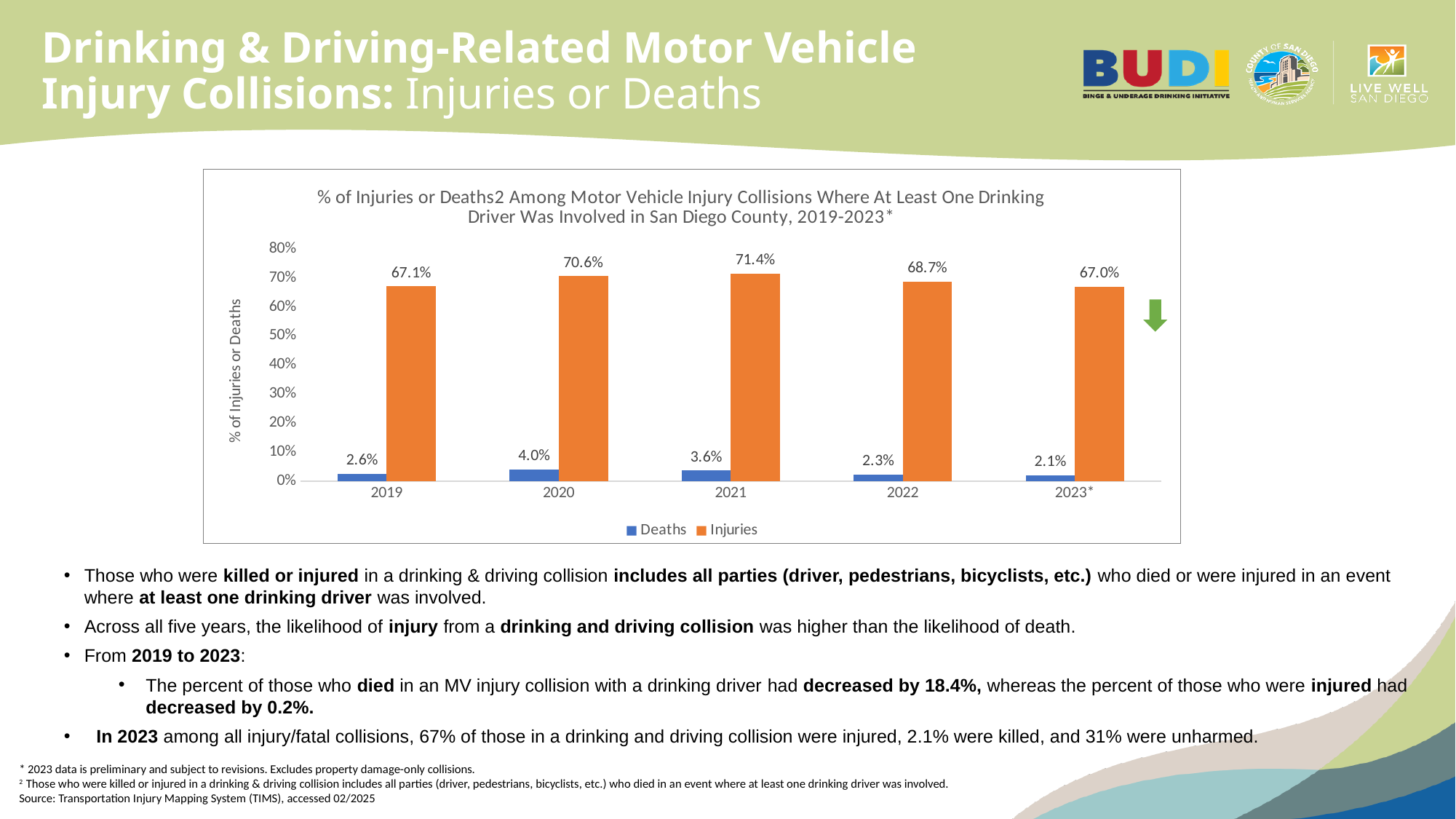
How many series does the legend list? 2 What is the Deaths value for 2023*? 2.1% Which year has the lowest Deaths value? 2023* Which year has the highest Injuries value? 2021 What colour are the Injuries bars? orange Is the Injuries value for 2022 greater or less than 60%? greater What kind of chart is shown? bar chart How many years are shown on the x axis? 5 What is the Injuries value for 2021? 71.4% What is the difference between the Injuries values for 2020 and 2019? 3.5% What is the Deaths value for 2020? 4.0% Which is larger, the Deaths value for 2021 or the Deaths value for 2022? 2021